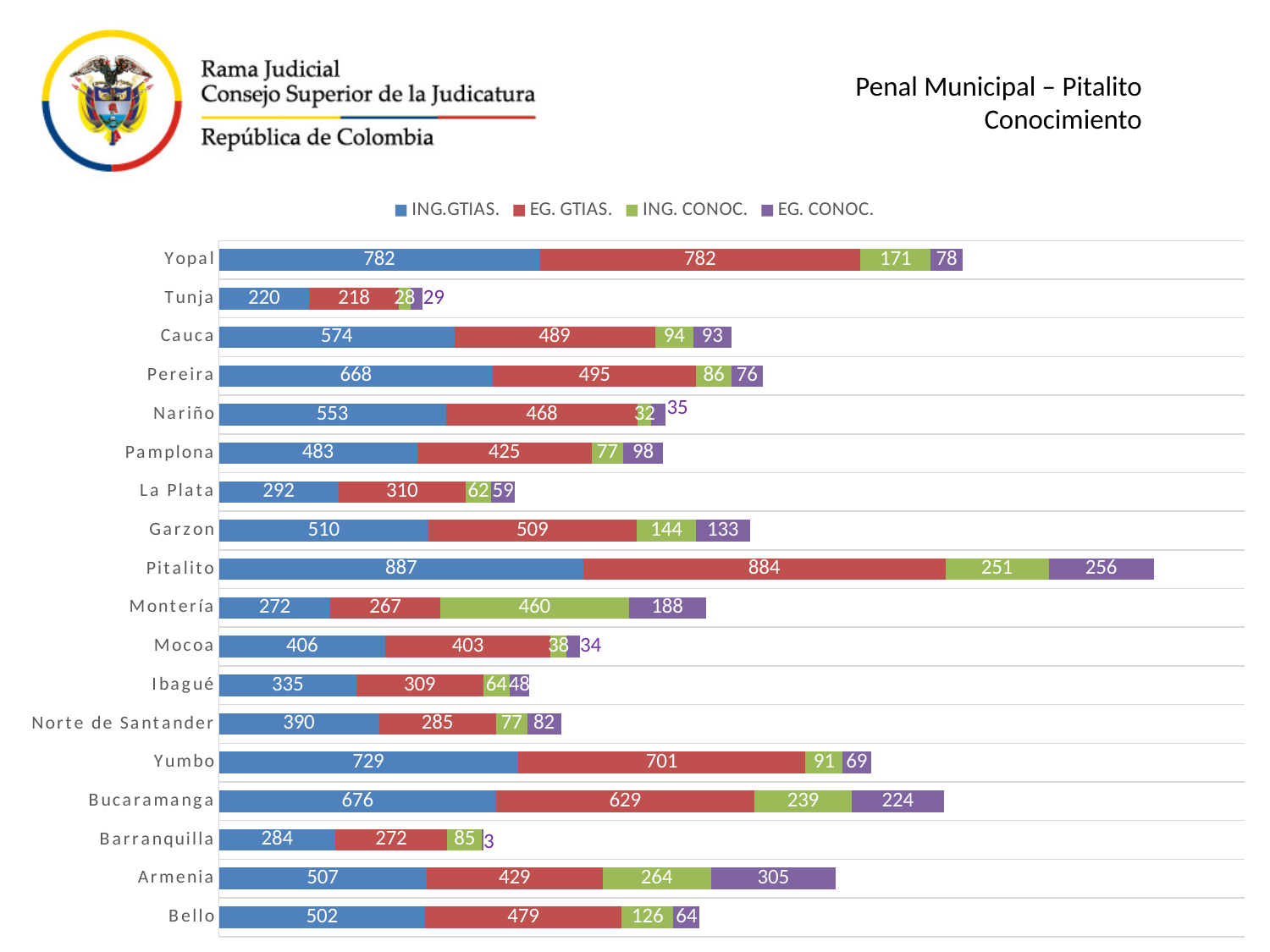
Which category has the highest EG. CONOC. value? Armenia Which category has the highest ING.GTIAS. value? Pitalito What is the ING. CONOC. value for Montería? 460 What is the difference between the ING.GTIAS. values for Pitalito and Yopal? 105 What kind of chart is shown on the slide? Stacked bar chart Which is larger, the EG. CONOC. value for Armenia or for Pitalito? Armenia What is the total of the stacked bar for Tunja? 495 How many series does the legend list? 4 How many categories are shown on the chart? 18 Which category has the lowest ING.GTIAS. value? Tunja What is the EG. CONOC. value for Barranquilla? 3 What is the ING.GTIAS. value for Pitalito? 887